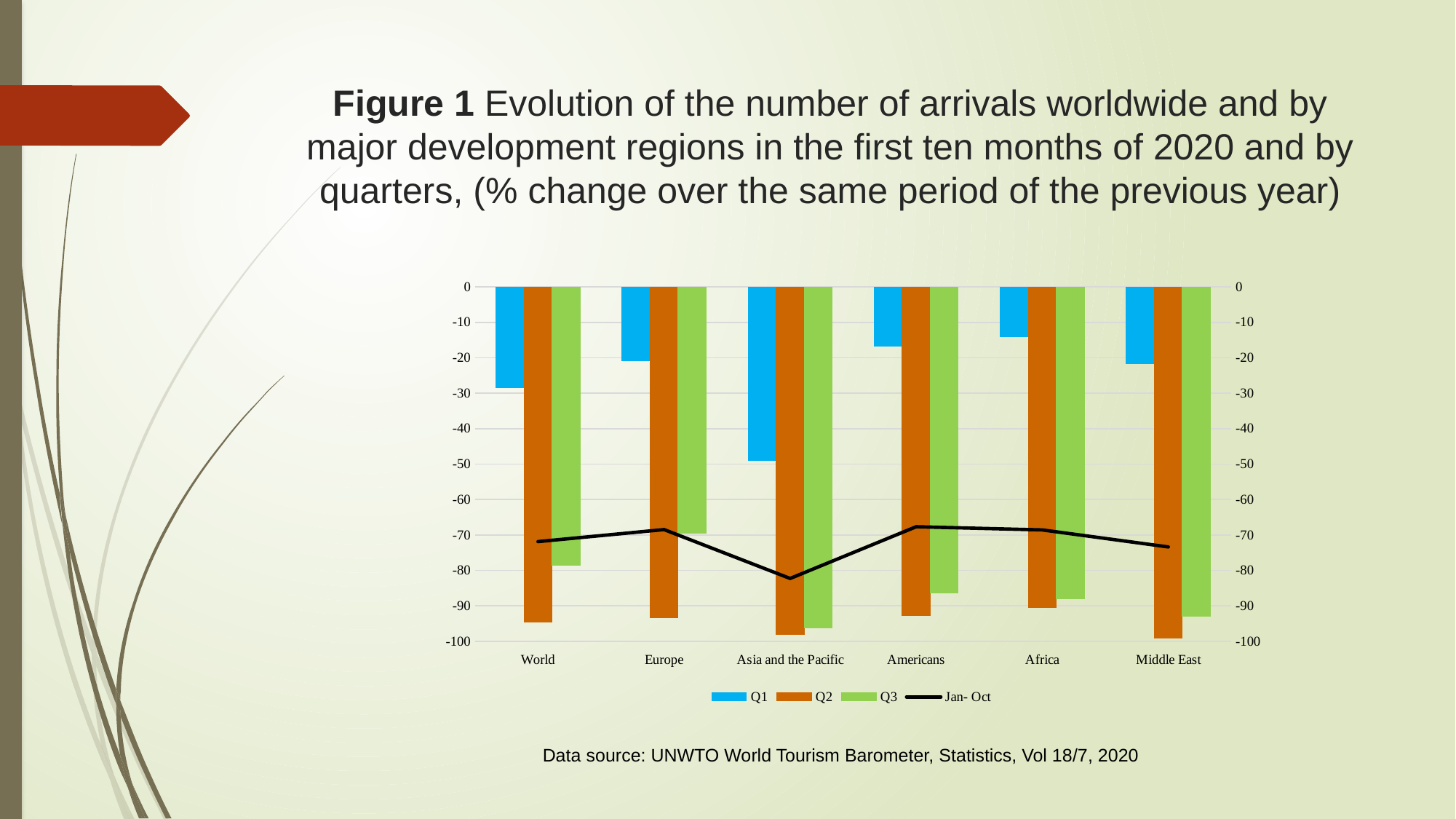
Is the Q3 value for Europe greater or less than -80? greater What kind of chart is shown on the slide? bar chart with a line series Which region has the highest (least negative) Q3 value? Europe How many series does the legend list? 4 How many regions (categories) are shown on the x axis? 6 Which series is drawn as a line rather than bars? Jan- Oct Is the Q1 value for World greater or less than -20? less Which region has the lowest point on the Jan- Oct line? Asia and the Pacific Which region has the highest (least negative) Q1 value? Africa Which region has the lowest (most negative) Q1 value? Asia and the Pacific Is the Q2 value for Africa greater or less than -80? less Which is larger, the Q1 value for Europe or the Q1 value for Asia and the Pacific? Europe